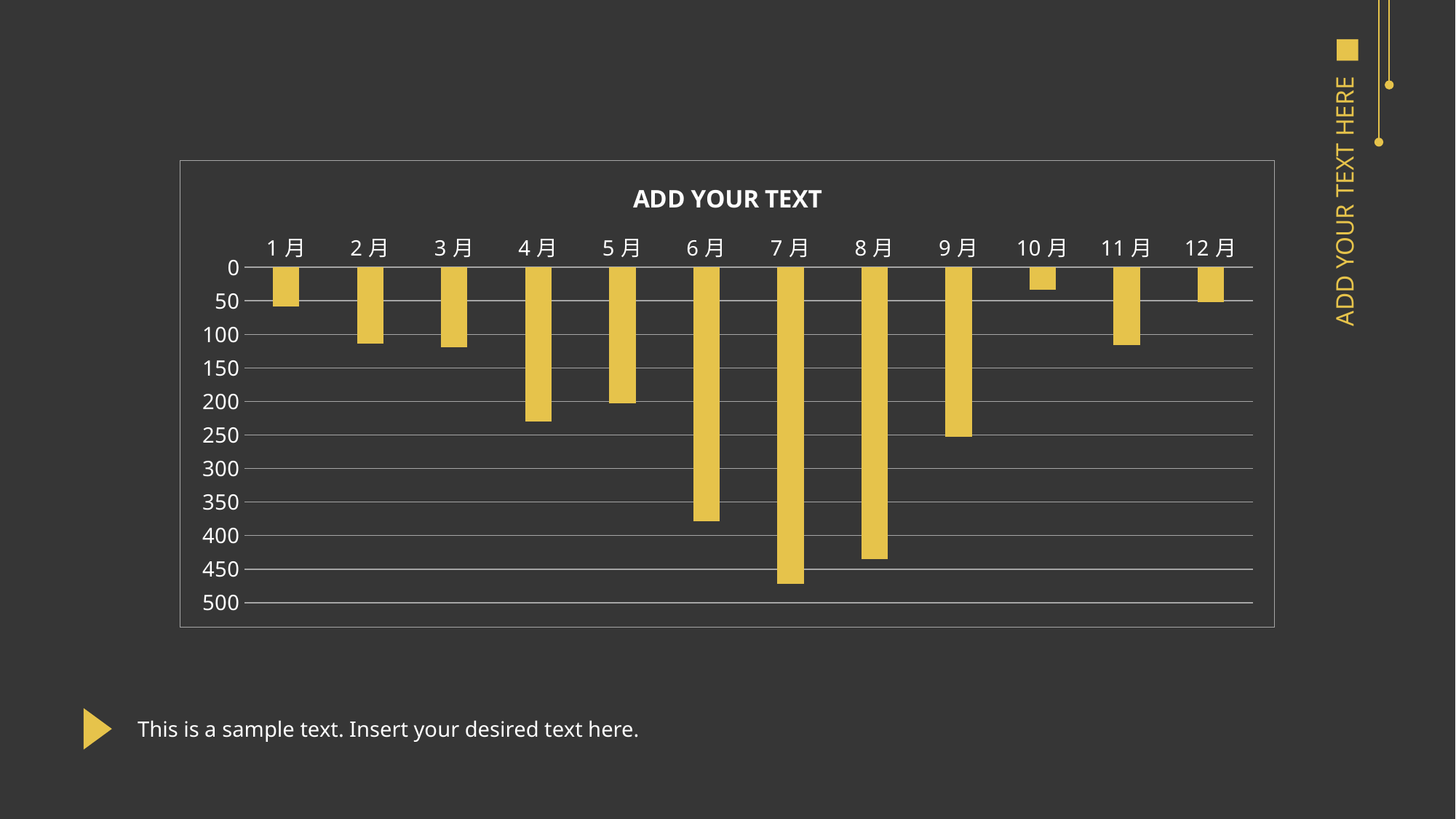
Which month has the shortest bar (lowest value) in the chart? 10月 Is the value for 8月 greater or less than 400? greater Is the value for 1月 greater or less than 100? less How many categories (months) are shown on the x axis of the chart? 12 What is the title of the chart? ADD YOUR TEXT Is the value for 4月 greater or less than 200? greater Do the bar values increase or decrease from 1月 to 7月? increase Which month has the longest bar (highest value) in the chart? 7月 Which has the larger value, 7月 or 8月? 7月 Which has the larger value, 6月 or 9月? 6月 What type of chart is shown on the slide? bar chart